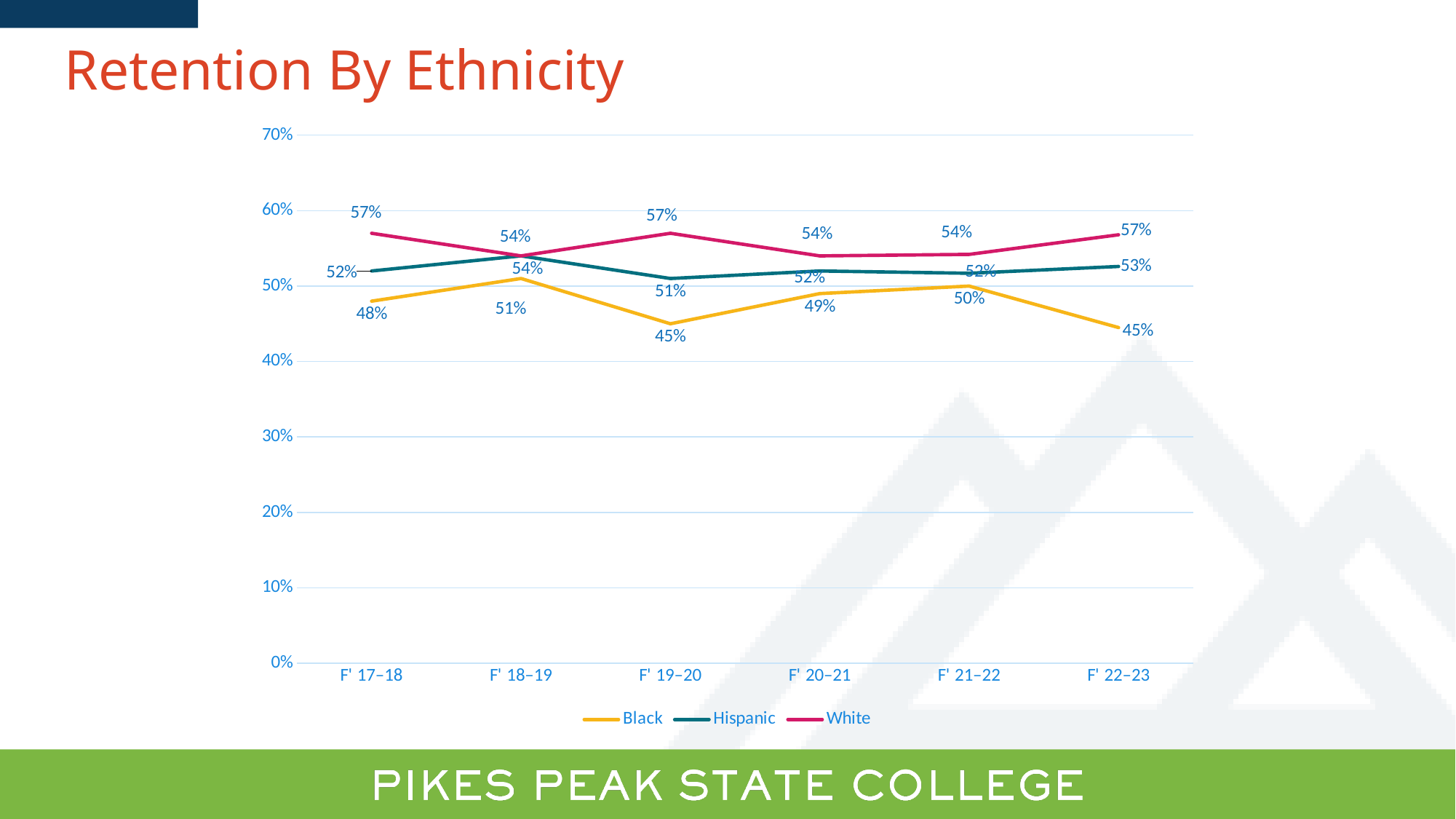
What is the retention rate for Black students in F' 19–20? 45% What is the retention rate for White students in F' 20–21? 54% How many terms are shown along the x axis? 6 How many series does the legend list? 3 In which term is the retention rate for Hispanic students lowest? F' 19–20 In which term is the retention rate for Black students highest? F' 18–19 Is the retention rate for Black students in F' 21–22 greater or less than 40%? greater What is the title of the chart? Retention By Ethnicity What is the difference between the White and Black retention rates in F' 22–23? 12% What is the retention rate for Hispanic students in F' 22–23? 53% What type of chart is shown on the slide? line chart Which group has the higher retention rate in F' 17–18, Black or Hispanic? Hispanic